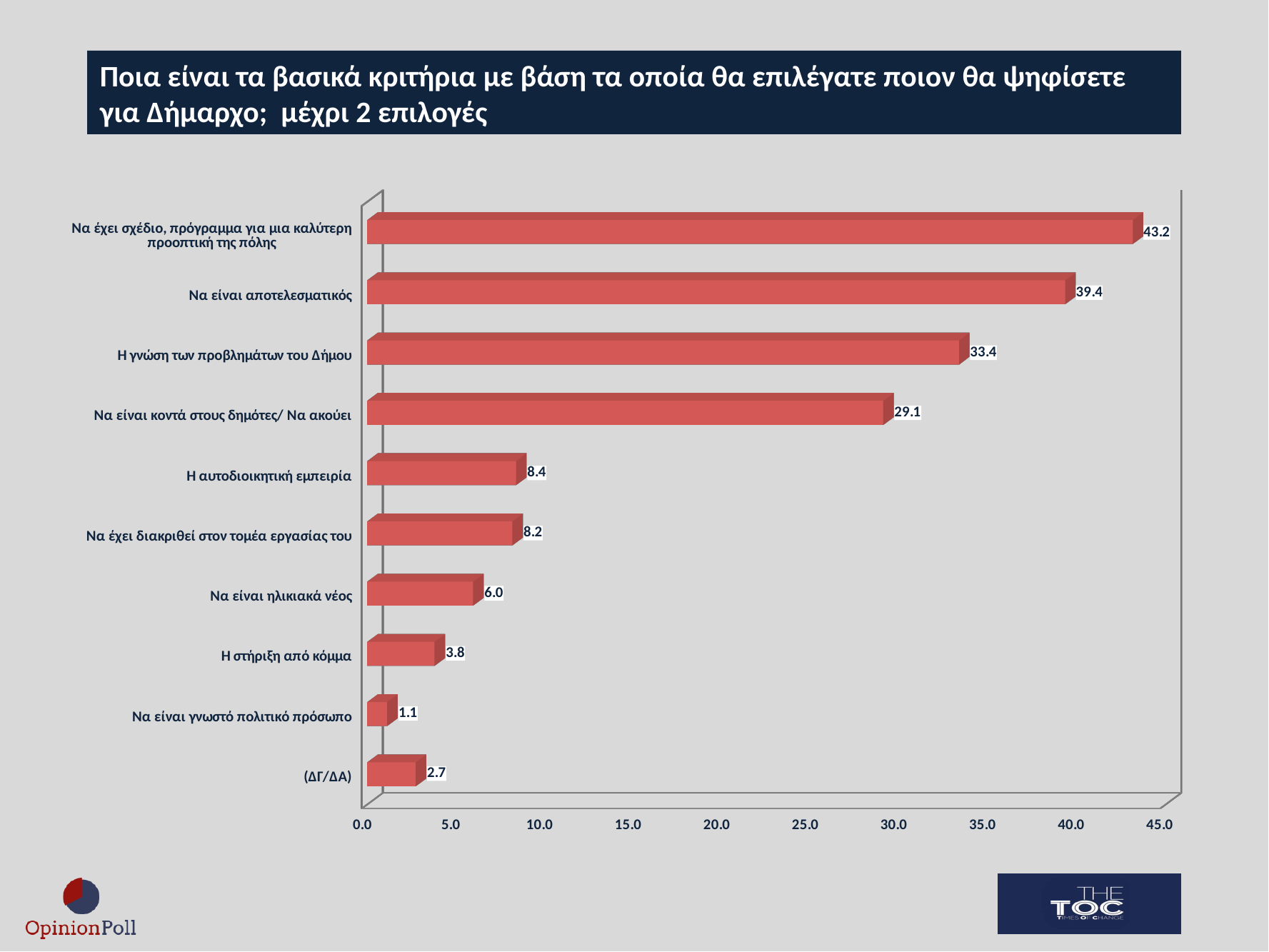
What kind of chart is shown on the slide? bar chart What is the value for "Να είναι αποτελεσματικός"? 39.4 What is the value for "Η στήριξη από κόμμα"? 3.8 Which is larger: the value for "Να είναι ηλικιακά νέος" or the value for "Η στήριξη από κόμμα"? Να είναι ηλικιακά νέος Is the value for "Να είναι αποτελεσματικός" greater or less than 35.0? greater Which category has the lowest value? Να είναι γνωστό πολιτικό πρόσωπο What is the difference between the highest value and the value for "Να είναι αποτελεσματικός"? 3.8 How many categories are shown in the chart? 10 What is the difference between the values for "Η γνώση των προβλημάτων του Δήμου" and "Να είναι κοντά στους δημότες/ Να ακούει"? 4.3 Which category has the highest value? Να έχει σχέδιο, πρόγραμμα για μια καλύτερη προοπτική της πόλης What is the value for "(ΔΓ/ΔΑ)"? 2.7 What is the highest tick value shown on the horizontal axis? 45.0